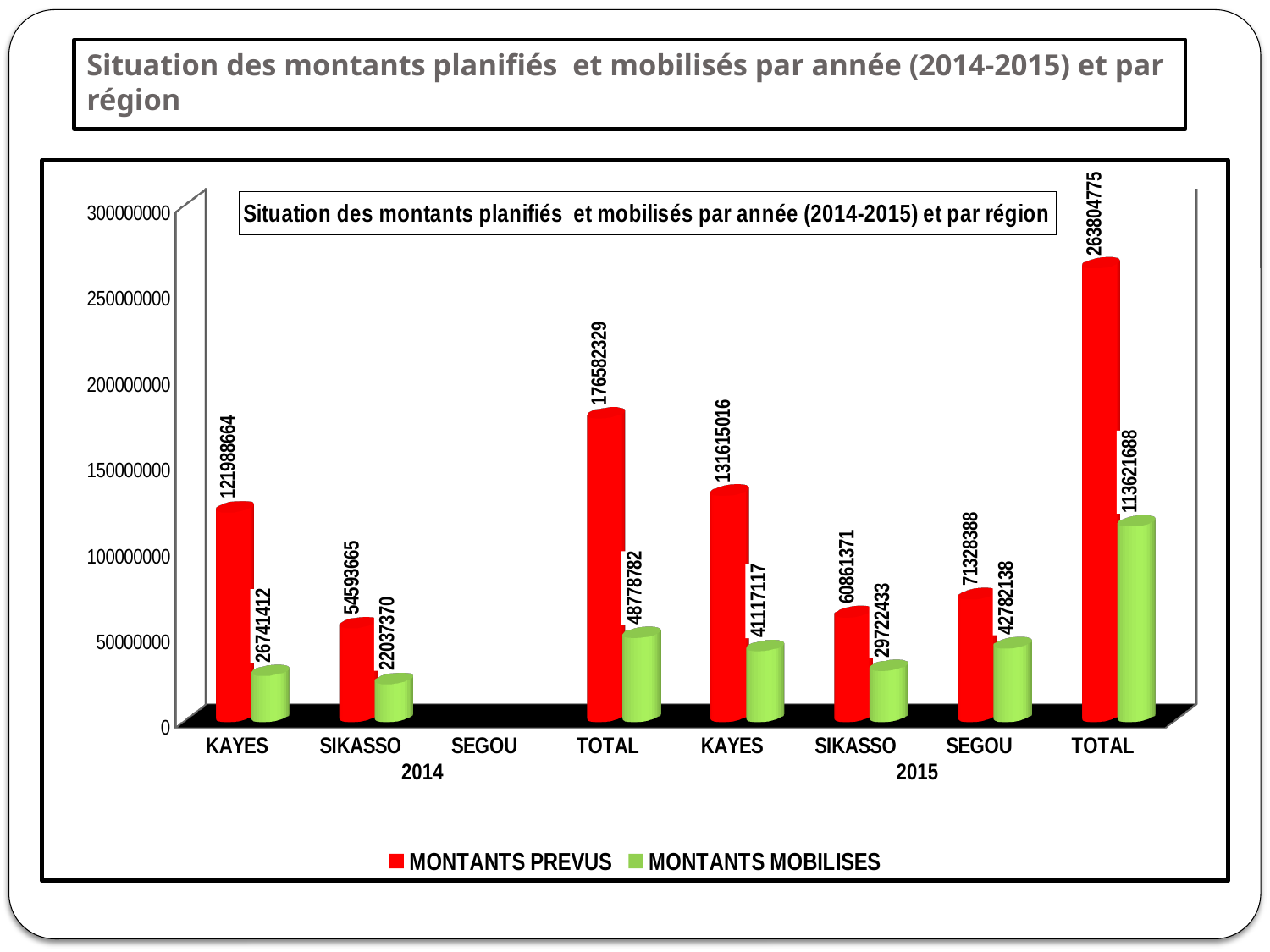
What is the MONTANTS PREVUS value for KAYES in 2014? 121988664 What is the MONTANTS MOBILISES value for SEGOU in 2015? 42782138 What is the MONTANTS PREVUS value for TOTAL in 2015? 263804775 Which category has the highest MONTANTS PREVUS value? TOTAL (2015) What colour represents MONTANTS MOBILISES in the chart? green Which region (excluding TOTAL) has the lowest MONTANTS MOBILISES value? SIKASSO (2014) What is the MONTANTS MOBILISES value for SIKASSO in 2014? 22037370 Is the MONTANTS MOBILISES value for TOTAL in 2015 greater or less than 100000000? greater What is the difference between MONTANTS PREVUS and MONTANTS MOBILISES for KAYES in 2015? 90497899 How many series does the legend list? 2 Which is larger: MONTANTS PREVUS for SIKASSO in 2015 or MONTANTS PREVUS for SEGOU in 2015? SEGOU in 2015 What kind of chart is shown on the slide? bar chart